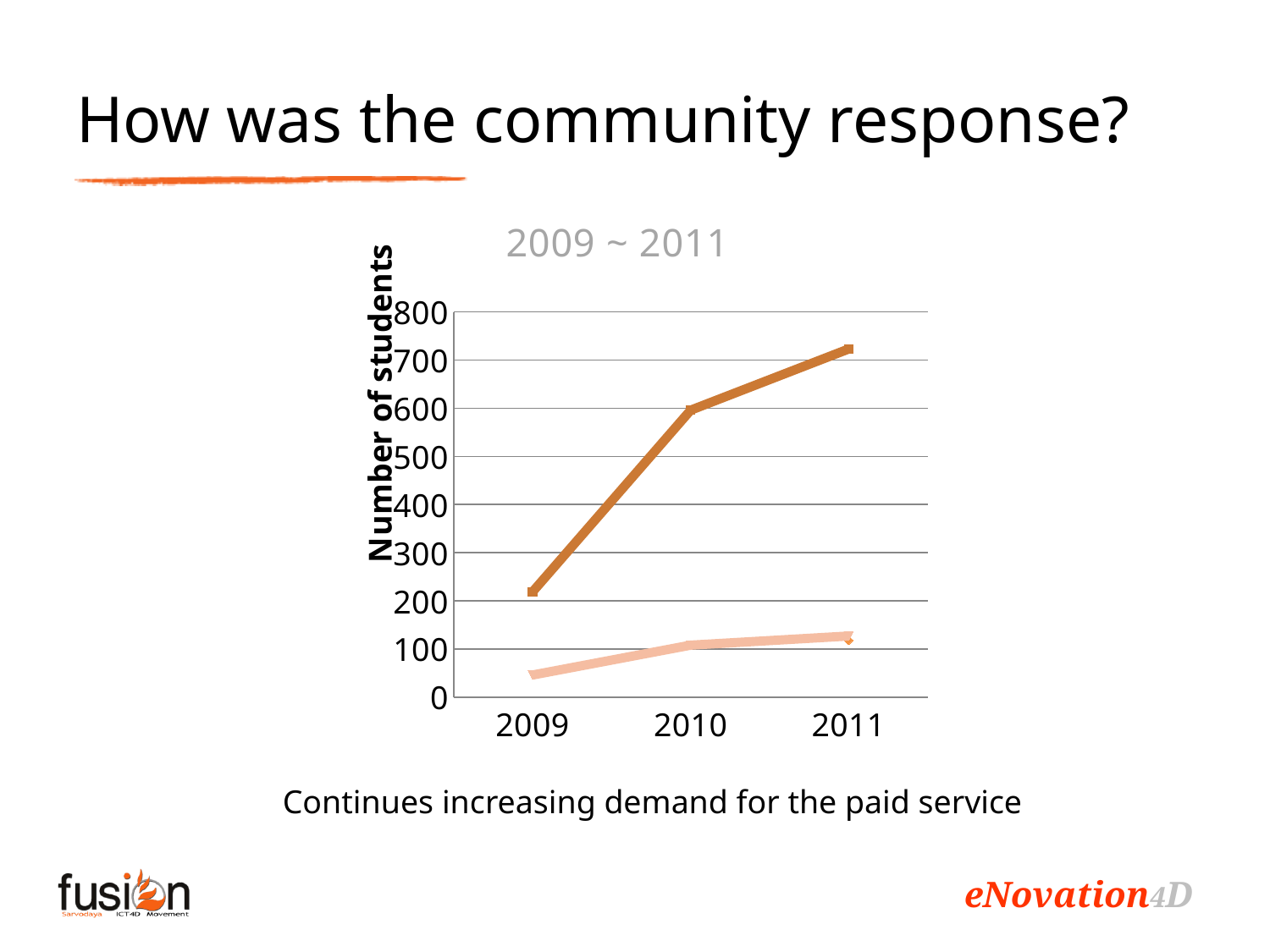
Does the darker orange line rise or fall from 2009 to 2011? rise Is the value of the lighter orange line in 2009 greater or less than 100? less What is the label on the vertical axis of the chart? Number of students In 2011, which line has the larger value, the darker orange line or the lighter orange line? the darker orange line Is the value of the darker orange line in 2009 greater or less than 300? less In which year does the darker orange line reach its highest value? 2011 How many lines are plotted on the chart? 2 In which year does the darker orange line have its lowest value? 2009 What is the title of the chart? 2009 ~ 2011 What kind of chart is shown on the slide? line chart How many years are shown along the x axis of the chart? 3 Is the value of the darker orange line in 2010 greater or less than 500? greater